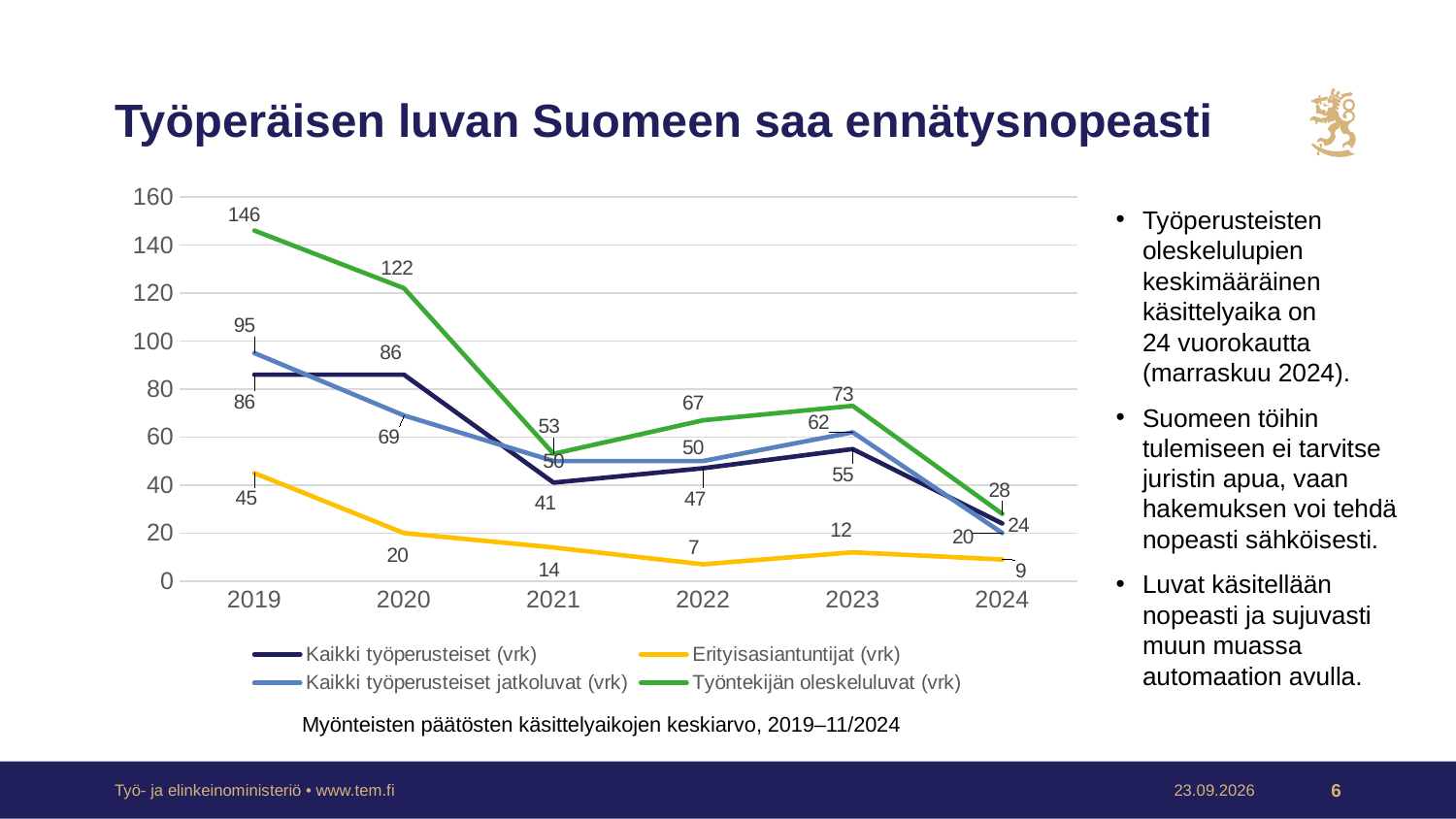
What is the value for Erityisasiantuntijat (vrk) in 2022? 7 What is the caption printed below the chart legend? Myönteisten päätösten käsittelyaikojen keskiarvo, 2019–11/2024 What is the value for Työntekijän oleskeluluvat (vrk) in 2019? 146 In which year is the value for Erityisasiantuntijat (vrk) lowest? 2022 What is the difference between the 2019 and 2024 values for Työntekijän oleskeluluvat (vrk)? 118 In 2023, which is larger: Kaikki työperusteiset (vrk) or Kaikki työperusteiset jatkoluvat (vrk)? Kaikki työperusteiset jatkoluvat (vrk) How many series does the legend list? 4 In which year is the value for Työntekijän oleskeluluvat (vrk) highest? 2019 How many years are shown on the x axis? 6 What kind of chart is shown on the slide? Line chart Does the value for Erityisasiantuntijat (vrk) rise or fall from 2019 to 2022? Fall What is the value for Kaikki työperusteiset (vrk) in 2024? 24